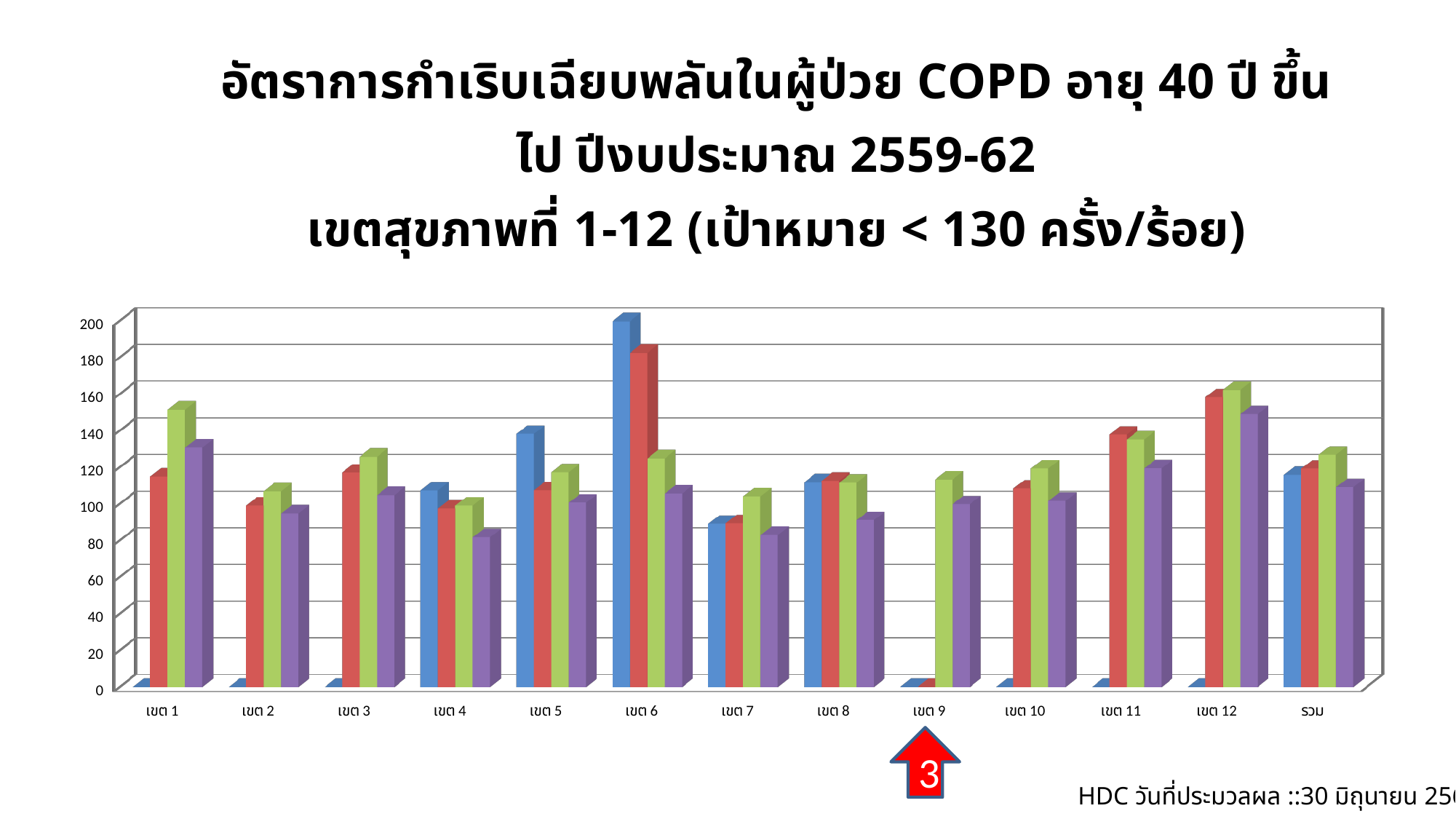
How many bars are plotted for each category in the chart? 4 Which is larger, the green bar for เขต 1 or the green bar for เขต 7? เขต 1 Is the value of the green bar for เขต 1 greater or less than 140? greater Which category has the tallest red bar? เขต 6 Which category has the tallest bar in the chart? เขต 6 How many categories are shown along the x axis of the chart? 13 What kind of chart is shown on the slide? bar chart Is the value of the blue bar for เขต 6 greater or less than 180? greater Is the value of the purple bar for เขต 4 greater or less than 100? less Which category does the red arrow below the chart point to? เขต 9 Which category has the tallest green bar? เขต 12